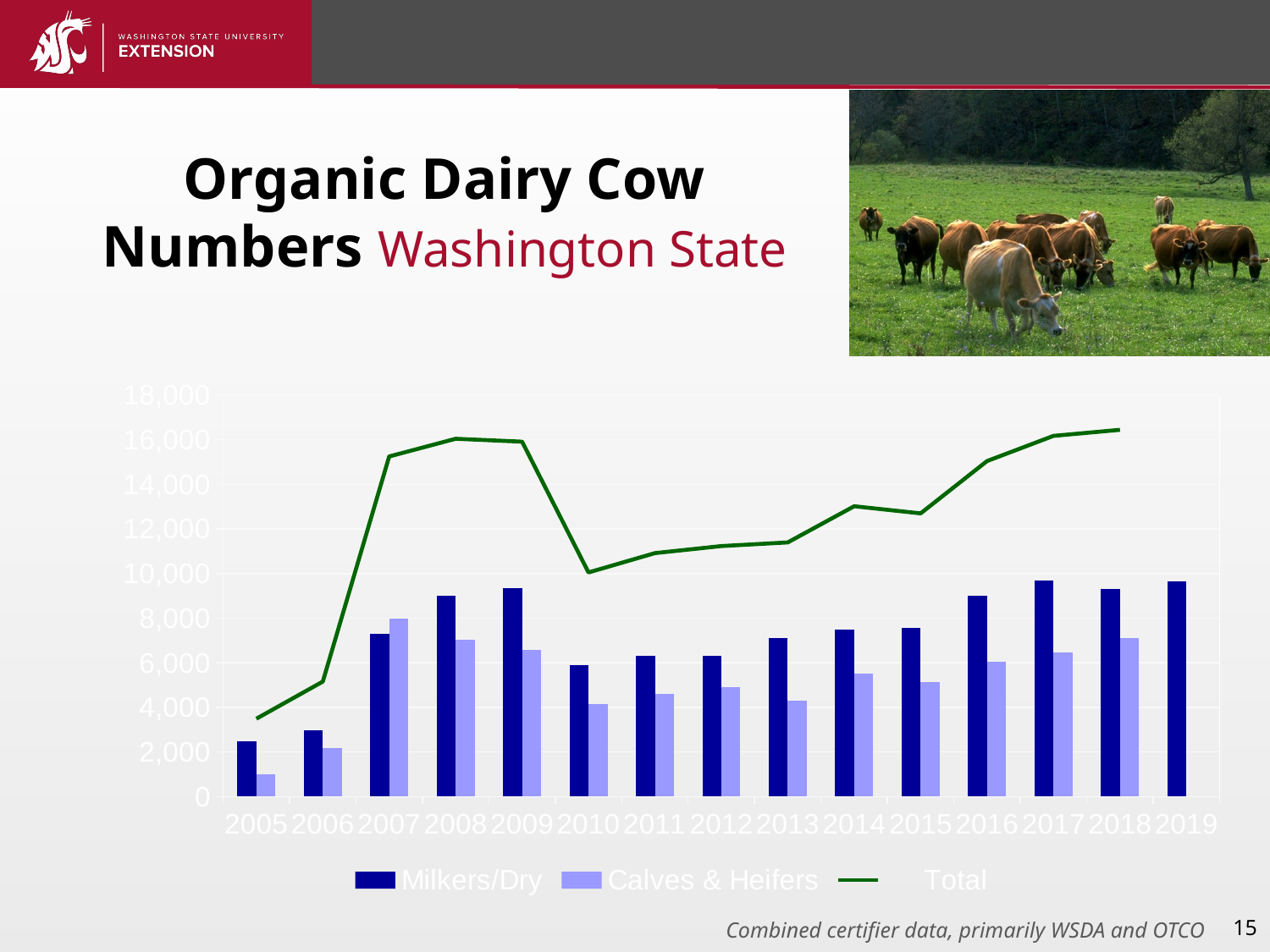
In which year is the Total value lowest? 2005 Is the Total value for 2015 greater or less than 12,000? greater Is the Milkers/Dry value for 2005 greater or less than 4,000? less In which year is the Calves & Heifers value highest? 2007 How many series does the legend list? 3 Is the Milkers/Dry value for 2017 greater or less than 10,000? less In 2007, which is larger: Milkers/Dry or Calves & Heifers? Calves & Heifers How many years are shown on the x axis? 15 Which series is drawn as a green line? Total What is the title of the slide containing the chart? Organic Dairy Cow Numbers Washington State What kind of chart is shown on the slide? A combined bar and line chart